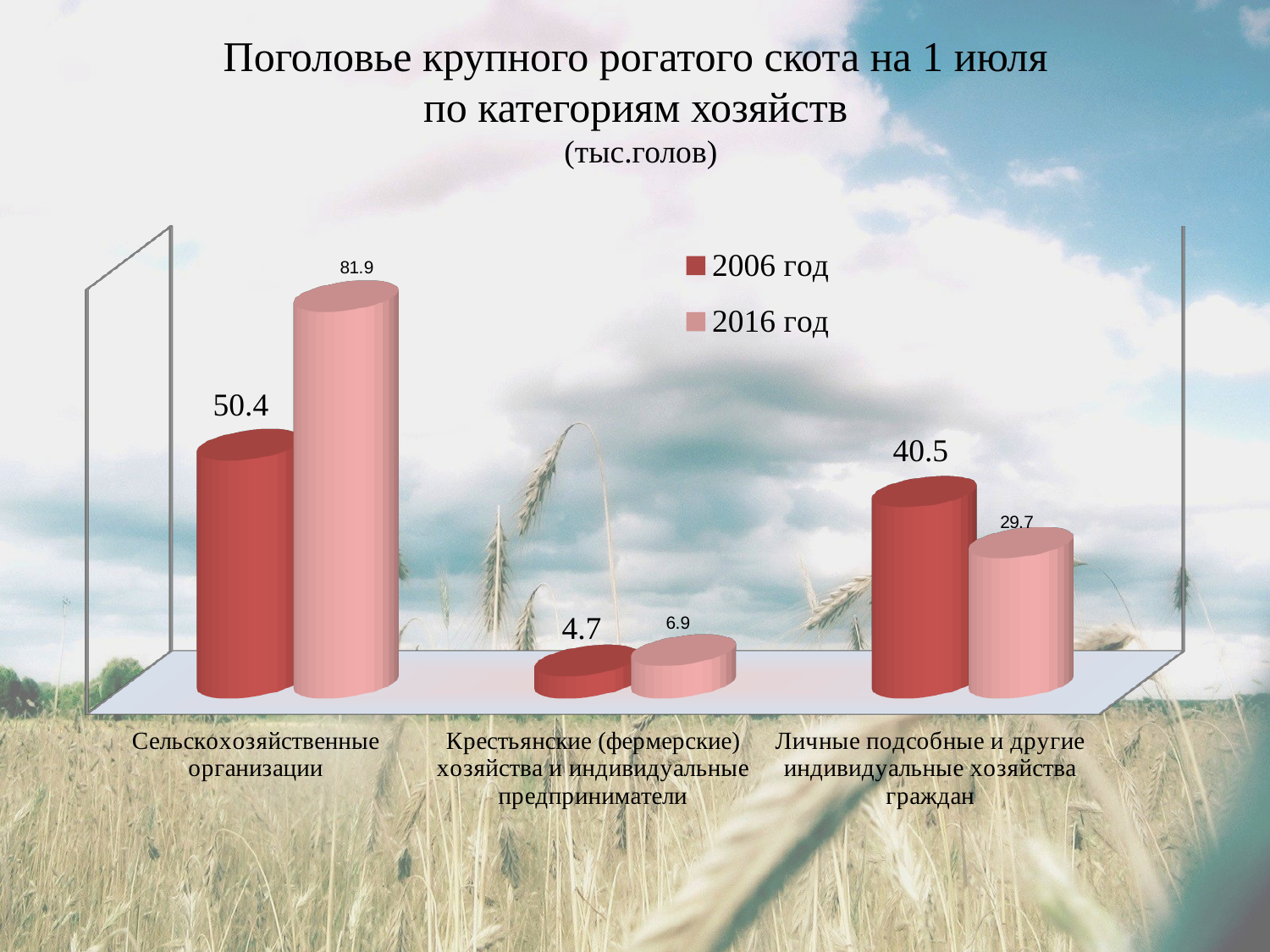
For Личные подсобные и другие индивидуальные хозяйства граждан, which year has the larger value, 2006 год or 2016 год? 2006 год What kind of chart is shown on the slide? Bar chart Which category has the lowest value in the 2006 год series? Крестьянские (фермерские) хозяйства и индивидуальные предприниматели What is the value for Сельскохозяйственные организации in the 2006 год series? 50.4 How many series does the legend list? 2 How many categories are shown on the x axis? 3 What is the value for Крестьянские (фермерские) хозяйства и индивидуальные предприниматели in the 2016 год series? 6.9 What is the value for Личные подсобные и другие индивидуальные хозяйства граждан in the 2006 год series? 40.5 What is the value for Сельскохозяйственные организации in the 2016 год series? 81.9 Which category has the highest value in the 2016 год series? Сельскохозяйственные организации What is the difference between the 2016 год and 2006 год values for Сельскохозяйственные организации? 31.5 What is the difference between the 2006 год and 2016 год values for Личные подсобные и другие индивидуальные хозяйства граждан? 10.8